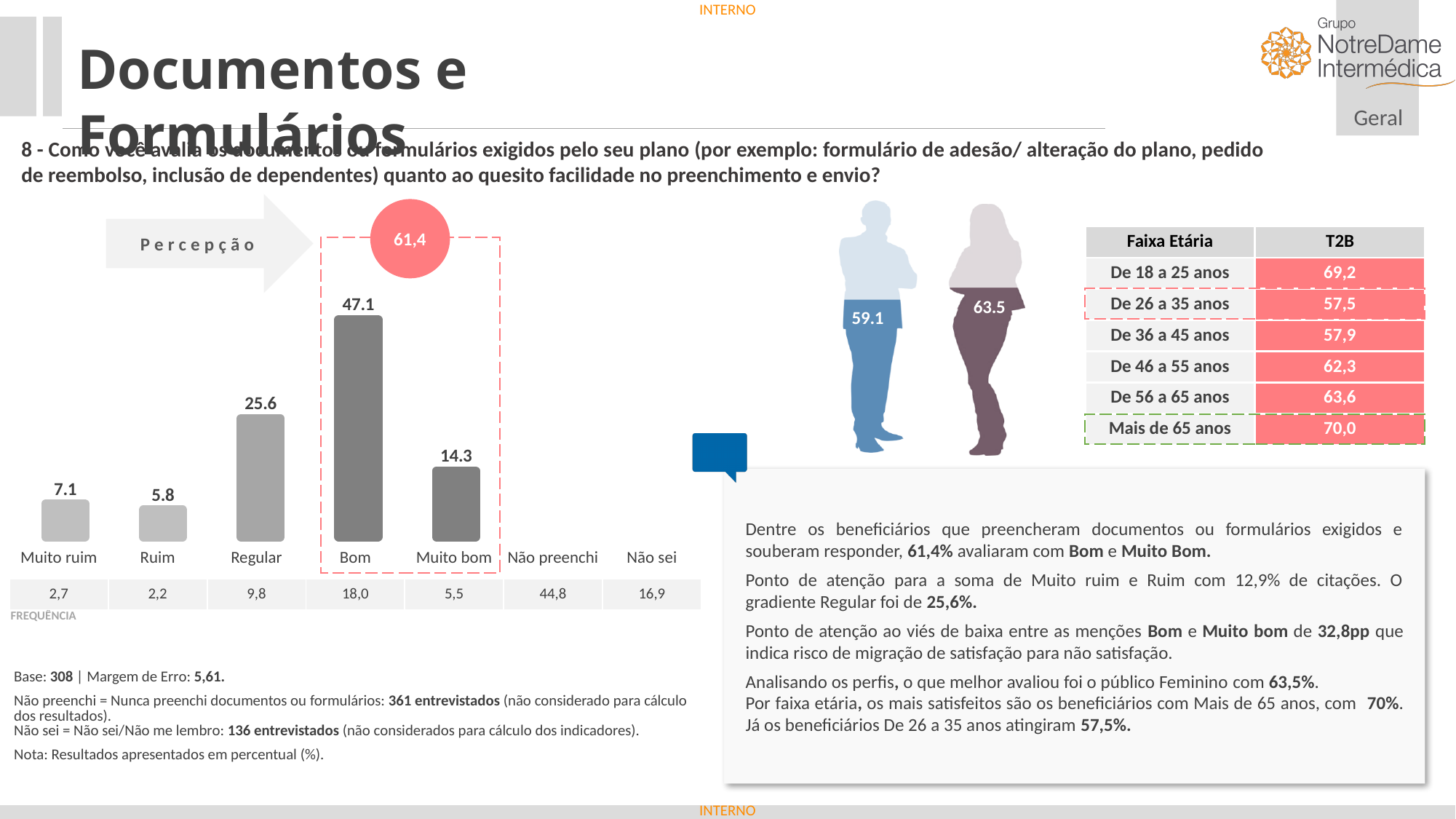
In the bar chart, what is the value for Regular? 25.6 In the bar chart, what value is shown in the pink circle above the dashed box around Bom and Muito bom? 61,4 In the bar chart, what is the value for Muito bom? 14.3 What type of chart is shown on the left of the slide? Bar chart In the bar chart, which is larger, the value for Muito ruim or the value for Ruim? Muito ruim In the bar chart, what is the difference between the values for Bom and Muito bom? 32.8 In the bar chart, what is the sum of the values for Bom and Muito bom? 61.4 In the bar chart, which category has the highest value? Bom In the bar chart, which category has the lowest value among the plotted bars? Ruim In the bar chart, what is the value for Bom? 47.1 How many bars are plotted in the bar chart? 5